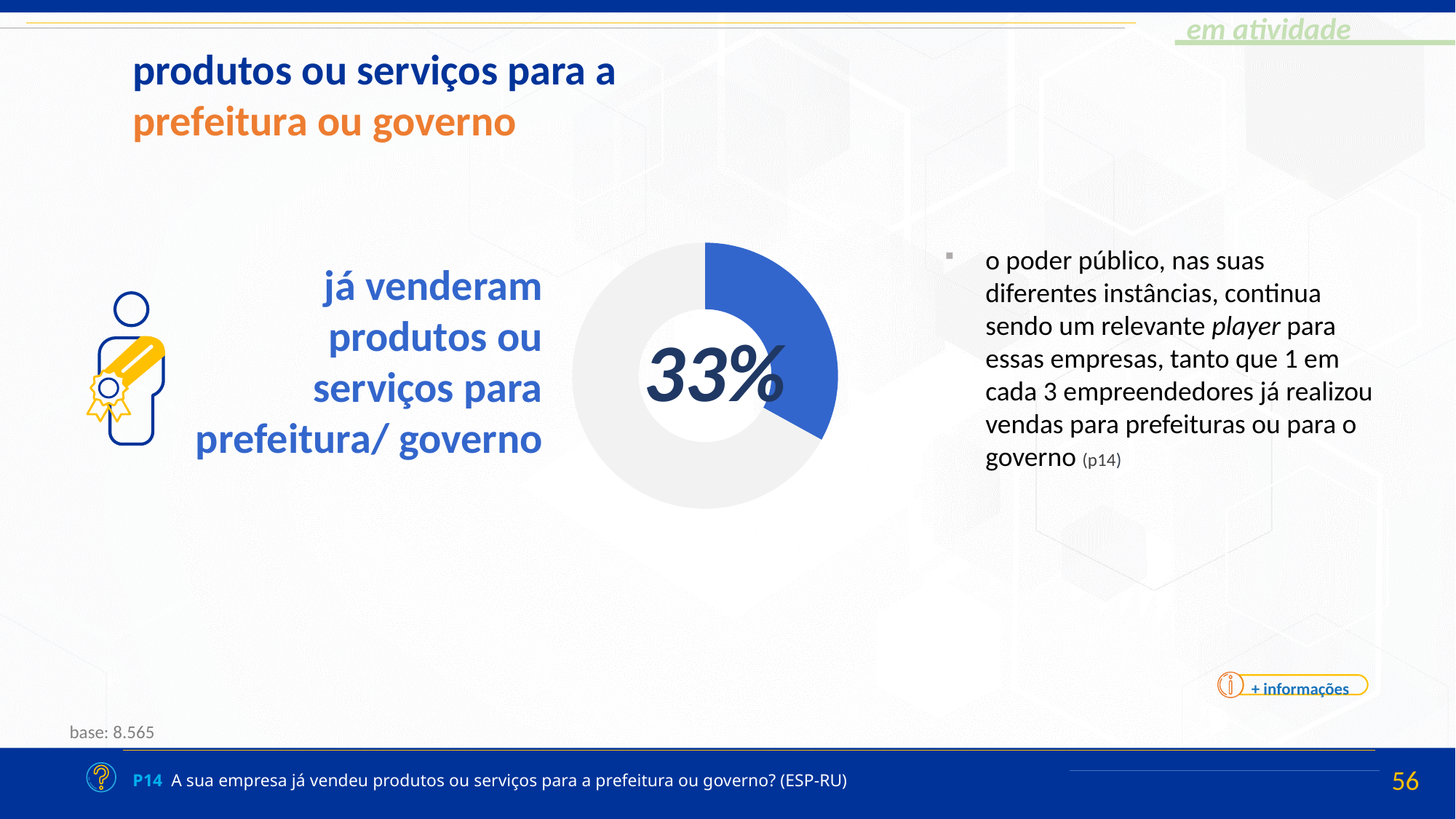
Which segment of the donut chart is larger, the blue one or the grey one? the grey one What share of the donut chart does the blue (highlighted) segment represent? 33% What kind of chart is shown on the slide? donut chart How many segments does the donut chart have? 2 What percentage of companies have already sold products or services to the prefeitura/governo, according to the chart? 33% Is the value shown in the donut chart greater or less than 50%? less What is the base (number of respondents) stated for the chart on the slide? 8.565 What colour is the segment representing the 33% value in the donut chart? blue What share of the donut chart is NOT covered by the 33% blue segment? 67%